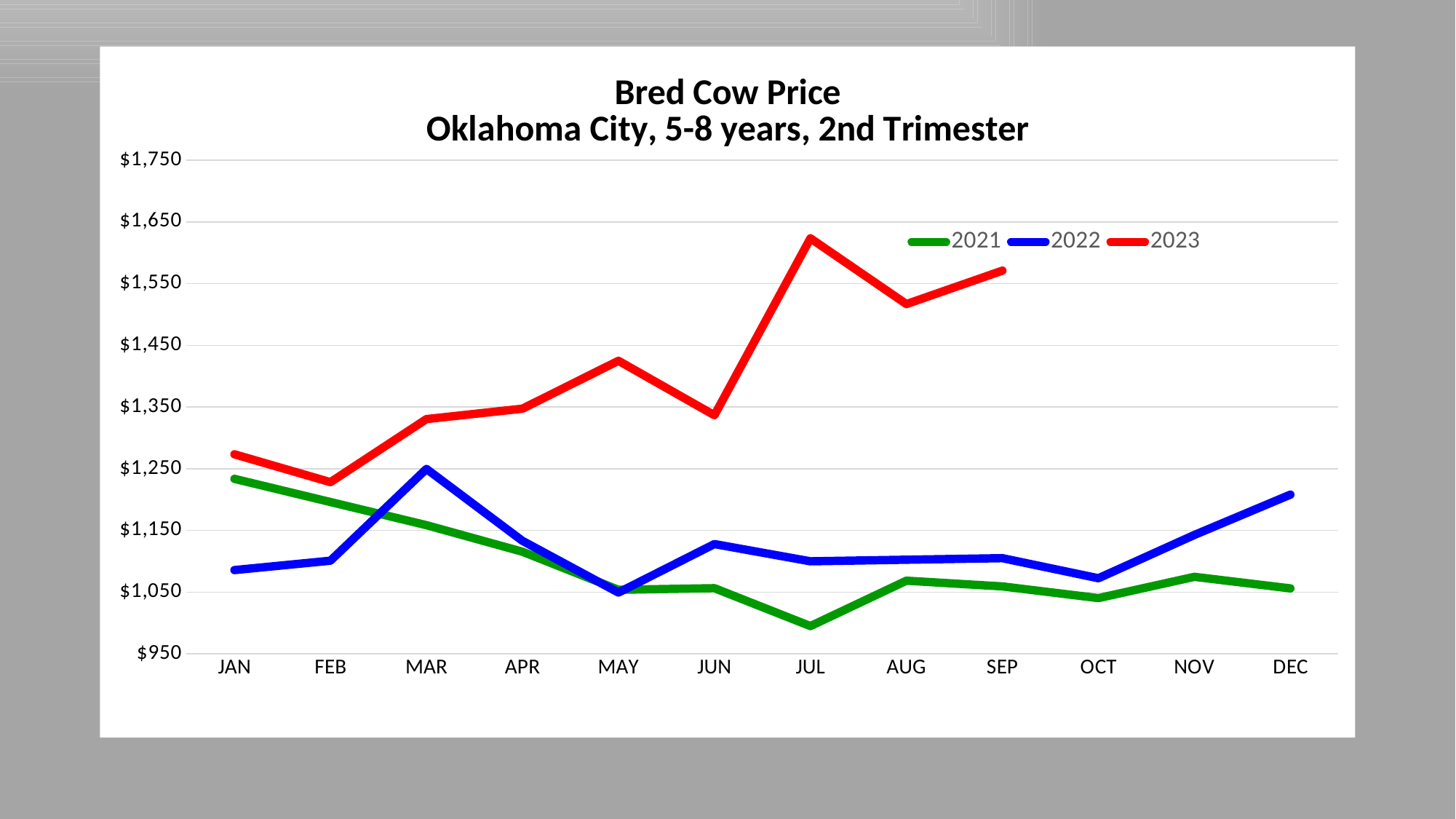
Is the 2021 value for JUL greater or less than $1,050? less In which month does the 2021 series reach its lowest value? JUL What colour is the line for the 2023 series? red In which month does the 2022 series reach its highest value? MAR In which month does the 2023 series reach its highest value? JUL In MAR, which series has the larger value, 2021 or 2022? 2022 What kind of chart is shown on the slide? line chart How many series does the legend list? 3 Does the 2021 series rise or fall from JAN to MAY? fall Is the 2023 value for JUL greater or less than $1,550? greater How many months are shown on the x axis? 12 Is the 2022 value for MAR greater or less than $1,150? greater